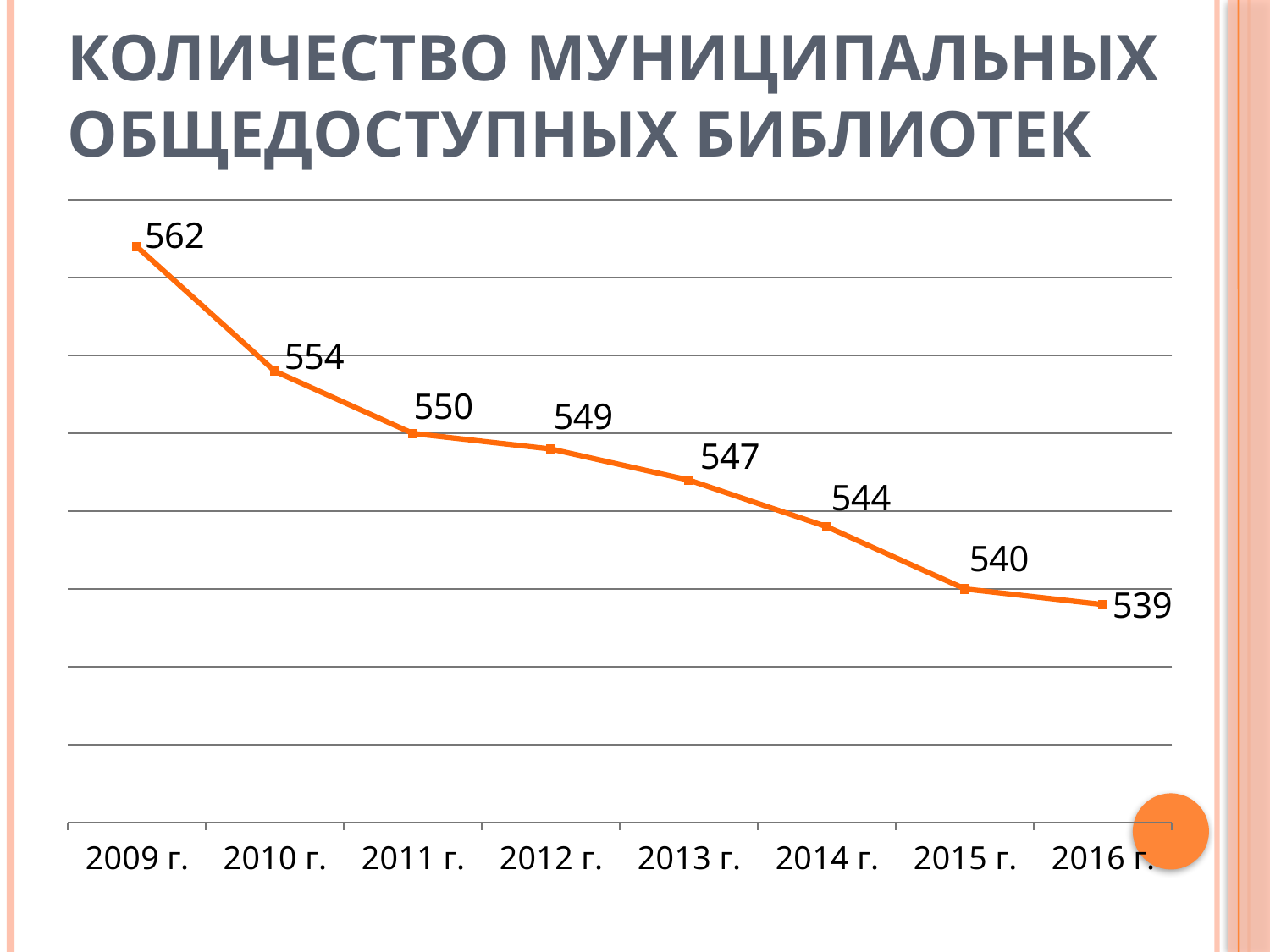
What kind of chart is shown? line chart Which year has the lowest value? 2016 г. What is the value for 2016 г.? 539 What is the difference between the values for 2010 г. and 2011 г.? 4 What is the value for 2013 г.? 547 Do the values rise or fall from 2009 г. to 2016 г.? fall Which year has the highest value? 2009 г. What is the value for 2009 г.? 562 How many years are plotted on the chart? 8 What is the title of the chart? Количество муниципальных общедоступных библиотек Which is larger, the value for 2012 г. or the value for 2014 г.? 2012 г. What is the difference between the values for 2009 г. and 2016 г.? 23